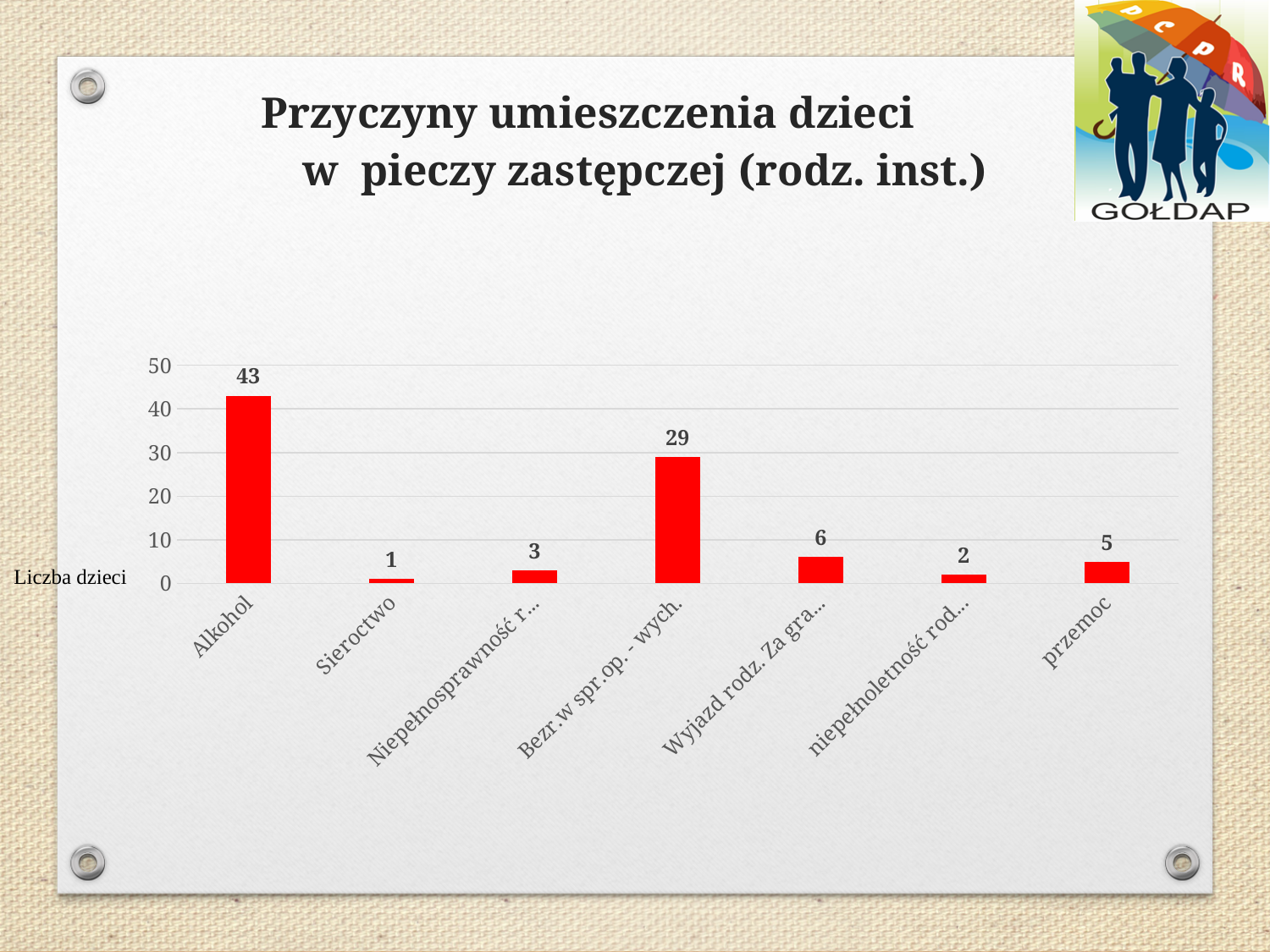
Which is larger, the value for przemoc or the value for Sieroctwo? przemoc What kind of chart is shown on the slide? bar chart What is the value for Sieroctwo? 1 What is the value for Bezr.w spr.op.- wych.? 29 How many categories are shown on the x axis? 7 What is the label shown next to the vertical axis? Liczba dzieci What is the value for Alkohol? 43 What is the difference between the values for Alkohol and Bezr.w spr.op.- wych.? 14 What is the value for przemoc? 5 Is the value for Bezr.w spr.op.- wych. greater or less than 20? greater Which category has the highest value? Alkohol Which category has the lowest value? Sieroctwo